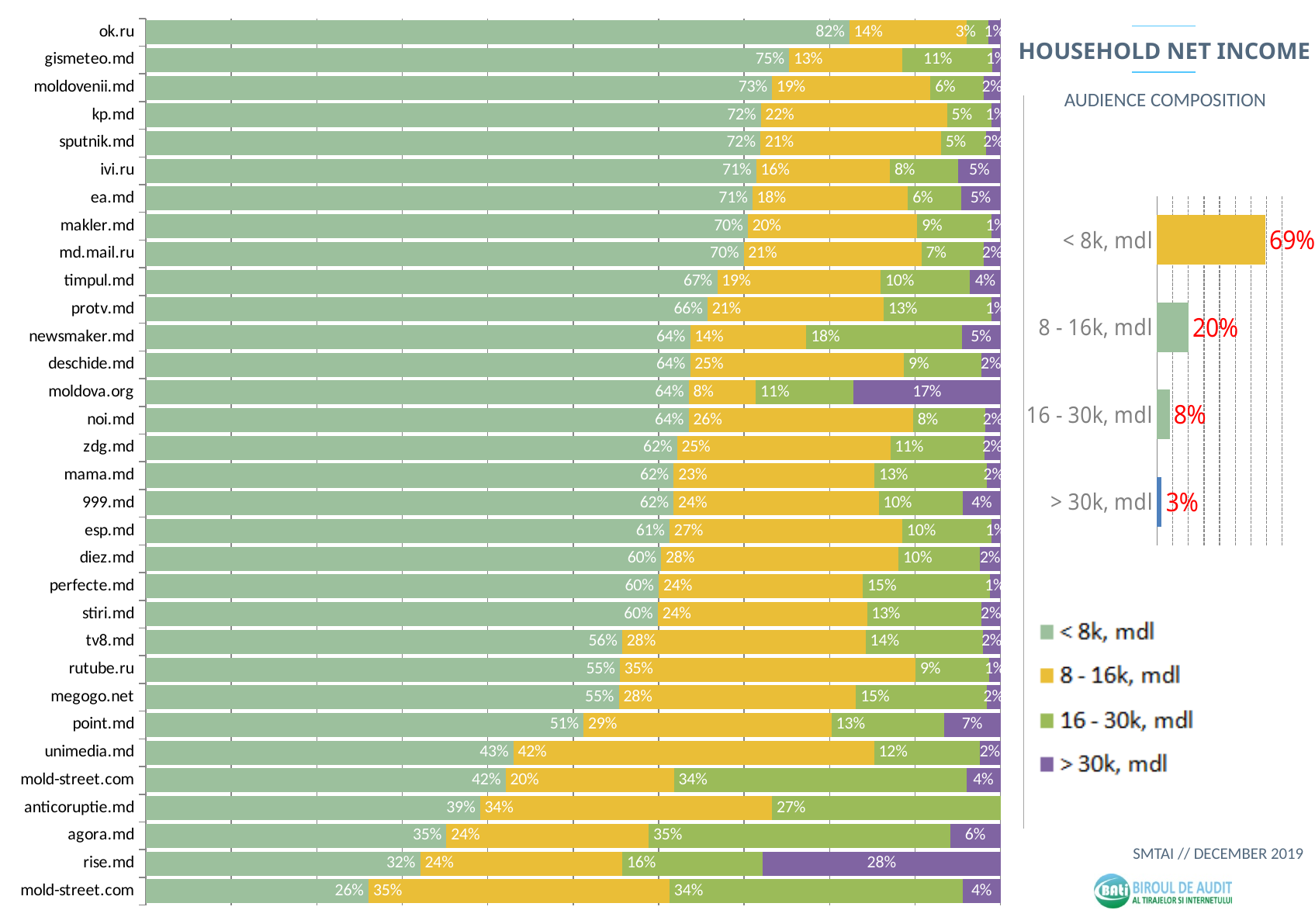
In the large stacked bar chart on the left, which has the larger 8 - 16k, mdl share: unimedia.md or rutube.ru? unimedia.md In the large stacked bar chart on the left, what is the < 8k, mdl share for ok.ru? 82% In the Audience Composition chart on the right, which income category has the highest value? < 8k, mdl In the Audience Composition chart on the right, what is the value for the < 8k, mdl category? 69% In the large stacked bar chart on the left, what is the > 30k, mdl share for moldova.org? 17% In the Audience Composition chart on the right, what is the difference between the < 8k, mdl value and the 8 - 16k, mdl value? 49 percentage points In the large stacked bar chart on the left, what is the 16 - 30k, mdl share for anticoruptie.md? 27% In the Audience Composition chart on the right, which income category has the lowest value? > 30k, mdl In the large stacked bar chart on the left, what is the > 30k, mdl share for rise.md? 28% What kind of chart is the large chart on the left of the slide? Stacked bar chart How many income categories does the legend of the left chart list? 4 In the large stacked bar chart on the left, which website has the highest < 8k, mdl share? ok.ru